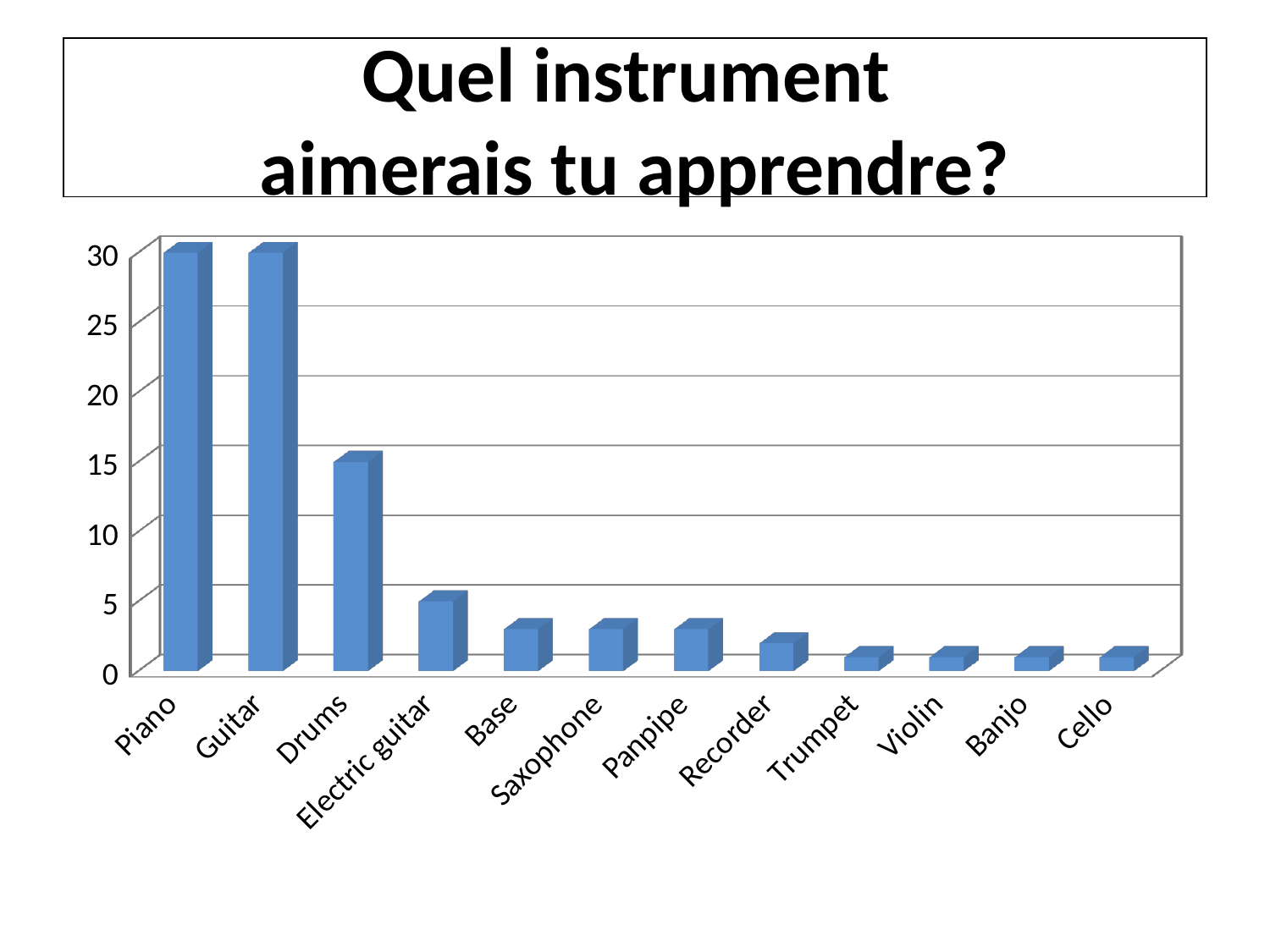
Which has a larger value, Guitar or Saxophone? Guitar Do the values generally rise or fall moving from left to right along the x axis? fall Is the value for Piano greater or less than 25? greater Is the value for Drums greater or less than 10? greater Is the value for Electric guitar greater or less than 10? less How many instruments (categories) are shown on the x axis of the chart? 12 What kind of chart is shown on the slide? bar chart Which has a larger value, Piano or Drums? Piano Which has a larger value, Drums or Electric guitar? Drums What is the title of the slide above the chart? Quel instrument aimerais tu apprendre?